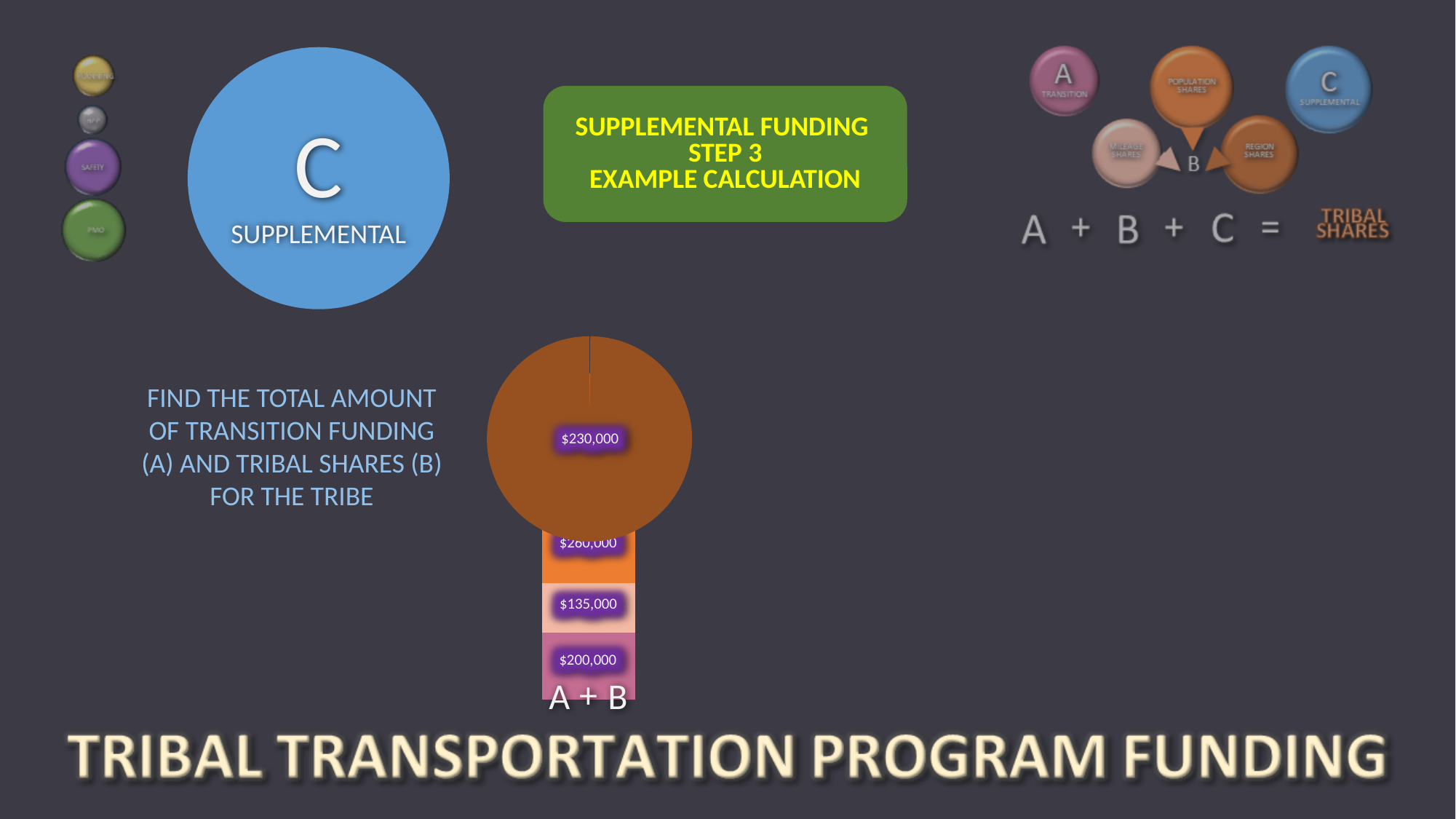
In the stacked bar chart labelled A + B, which is larger, the bottom segment or the middle segment? The bottom segment ($200,000) In the stacked bar chart labelled A + B, what is the difference between the bottom segment ($200,000) and the middle segment ($135,000)? $65,000 What kind of chart is the chart labelled A + B at the bottom centre of the slide? Stacked bar chart Is the value printed on the pie chart greater or less than $200,000? greater What value is printed on the brown pie chart above the stacked bar? $230,000 Which is larger, the value on the pie chart ($230,000) or the bottom segment of the stacked bar ($200,000)? The pie chart value ($230,000) What kind of chart is the brown circular chart in the centre of the slide? Pie chart In the stacked bar chart labelled A + B, what is the value of the middle (peach) segment? $135,000 In the stacked bar chart labelled A + B, is the value of the middle segment greater or less than $150,000? less In the stacked bar chart labelled A + B, what is the value of the bottom (pink) segment? $200,000 What is the category label printed beneath the stacked bar? A + B